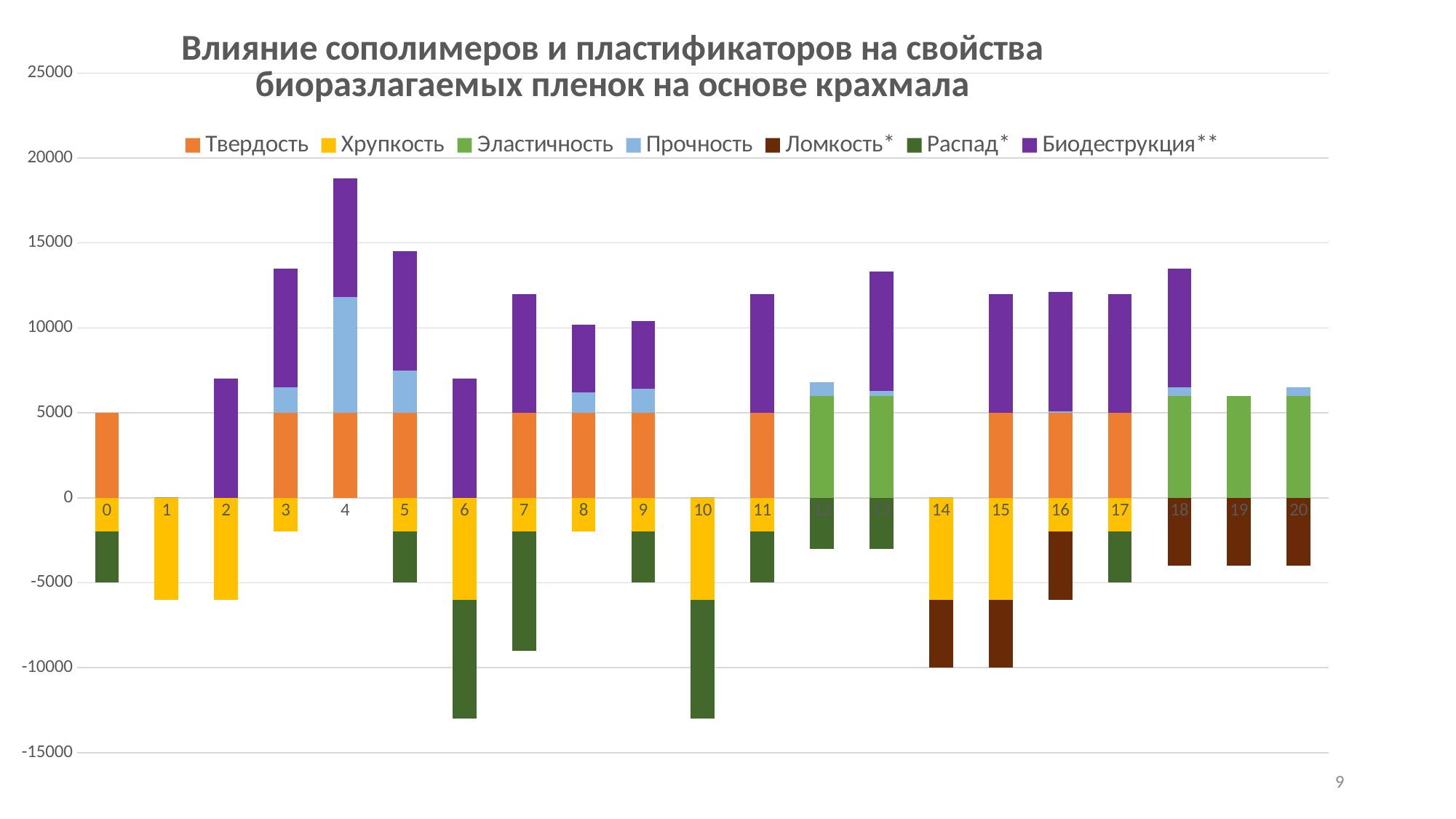
Which has the taller positive stacked bar, category 4 or category 2? 4 What is the title of the chart? Влияние сополимеров и пластификаторов на свойства биоразлагаемых пленок на основе крахмала Is the top of the positive stack for category 2 greater or less than 10000? less What kind of chart is shown on the slide? Stacked bar chart Which series is shown in purple in the legend? Биодеструкция** Which category has the tallest positive stacked bar? 4 Is the top of the positive stack for category 4 greater or less than 15000? greater What is the value of Твердость for category 0? 5000 How many series does the legend list? 7 Is the bottom of the negative stack for category 6 greater or less than -10000? less How many categories are shown along the x axis? 21